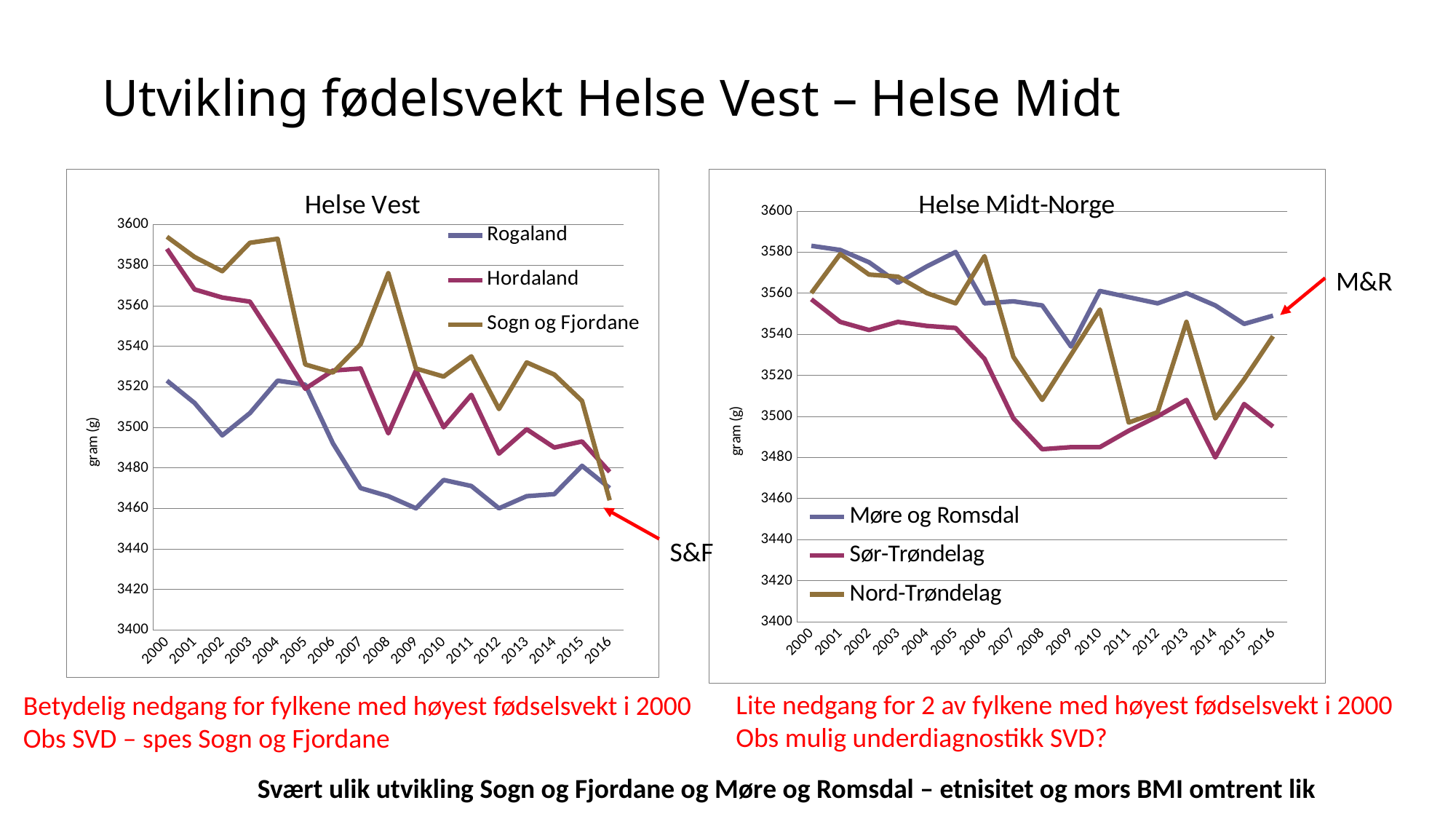
In the Helse Vest chart, which series has the lowest value in 2000? Rogaland In the Helse Vest chart, is the value for Rogaland in 2009 greater or less than 3480? less What type of chart is the Helse Vest chart? line chart What is the y-axis label of the Helse Vest chart? gram (g) In the Helse Midt-Norge chart, which is larger in 2000: Møre og Romsdal or Sør-Trøndelag? Møre og Romsdal In the Helse Midt-Norge chart, is the value for Møre og Romsdal in 2005 greater or less than 3560? greater In the Helse Midt-Norge chart, which series has the lowest value in 2016? Sør-Trøndelag How many series does the legend of the Helse Midt-Norge chart list? 3 In the Helse Vest chart, does the Sogn og Fjordane series overall rise or fall from 2000 to 2016? fall In the Helse Vest chart, is the value for Sogn og Fjordane in 2008 greater or less than 3560? greater How many years are shown on the x axis of the Helse Vest chart? 17